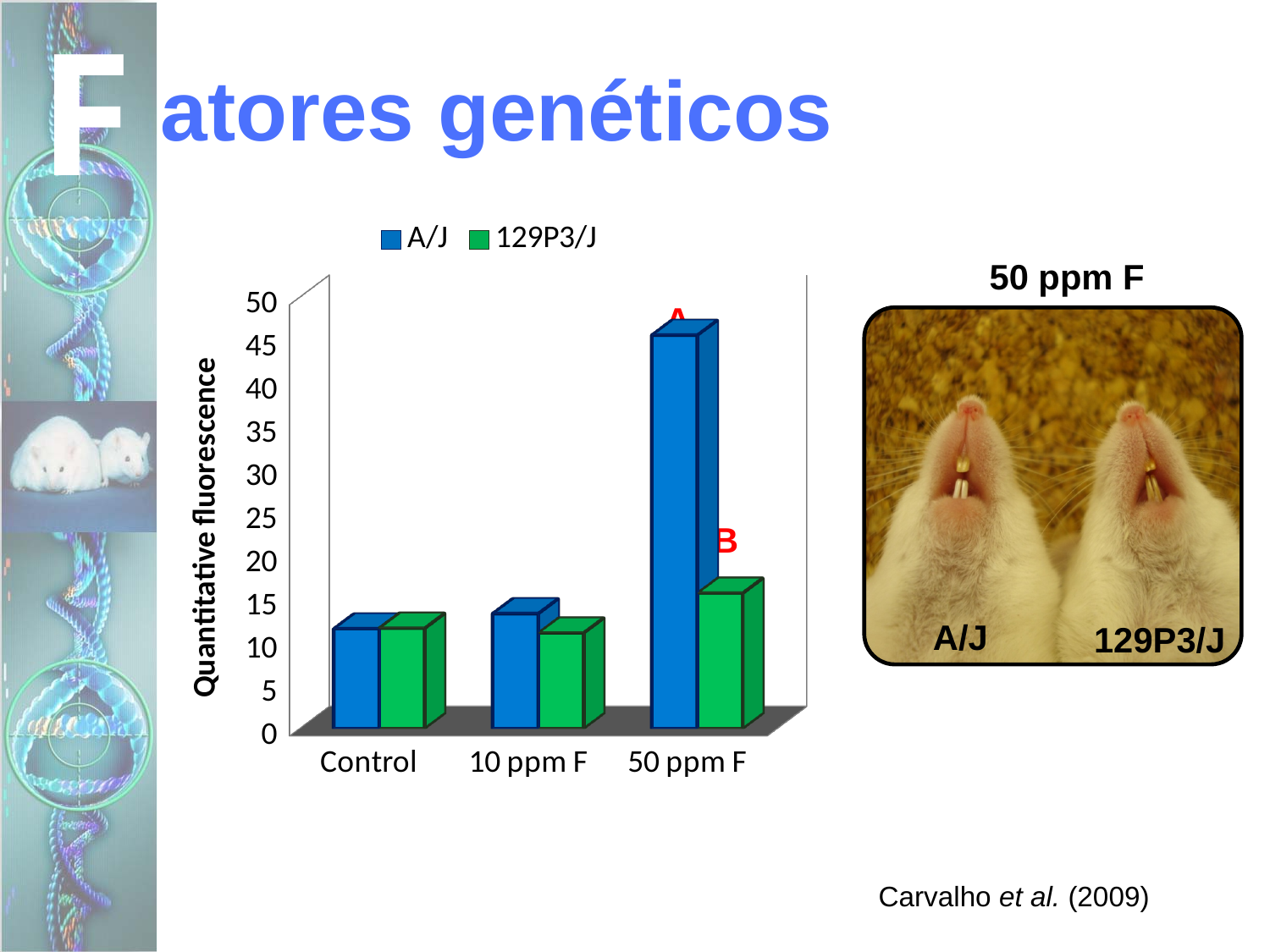
What is the label of the vertical axis of the chart? Quantitative fluorescence Do the A/J values rise or fall from Control to 50 ppm F? rise What kind of chart is shown on the slide? bar chart Is the value for 129P3/J at 10 ppm F greater or less than 15? less Which colour represents the 129P3/J series in the chart? green How many series does the chart legend list? 2 Which series and category has the highest bar in the chart? A/J at 50 ppm F At 50 ppm F, which series has the larger value, A/J or 129P3/J? A/J How many categories are shown on the x axis of the chart? 3 Is the value for A/J in the Control group greater or less than 15? less Is the value for 129P3/J at 50 ppm F greater or less than 20? less